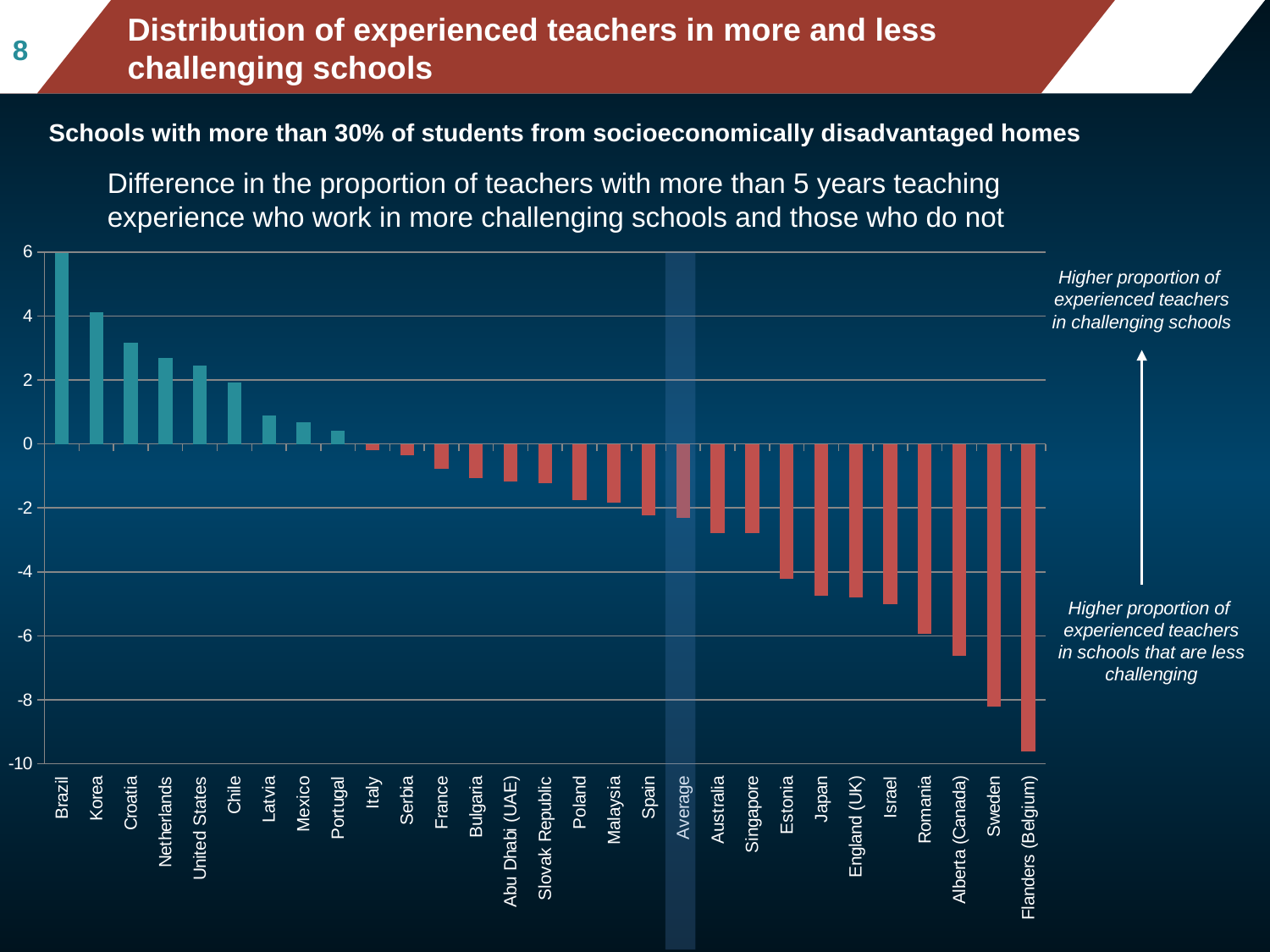
Is the value for Australia greater or less than -2? less Is the value for Latvia greater or less than 2? less Which country has the highest value in the chart? Brazil Which category is highlighted with a shaded vertical band in the chart? Average How many categories (including Average) are plotted along the x axis? 29 Is the value for Brazil greater or less than 4? greater Which has the larger value, Brazil or Korea? Brazil What kind of chart is shown on the slide? bar chart Which category has the lowest value in the chart? Flanders (Belgium) Do the values rise or fall moving from left to right along the x axis? fall